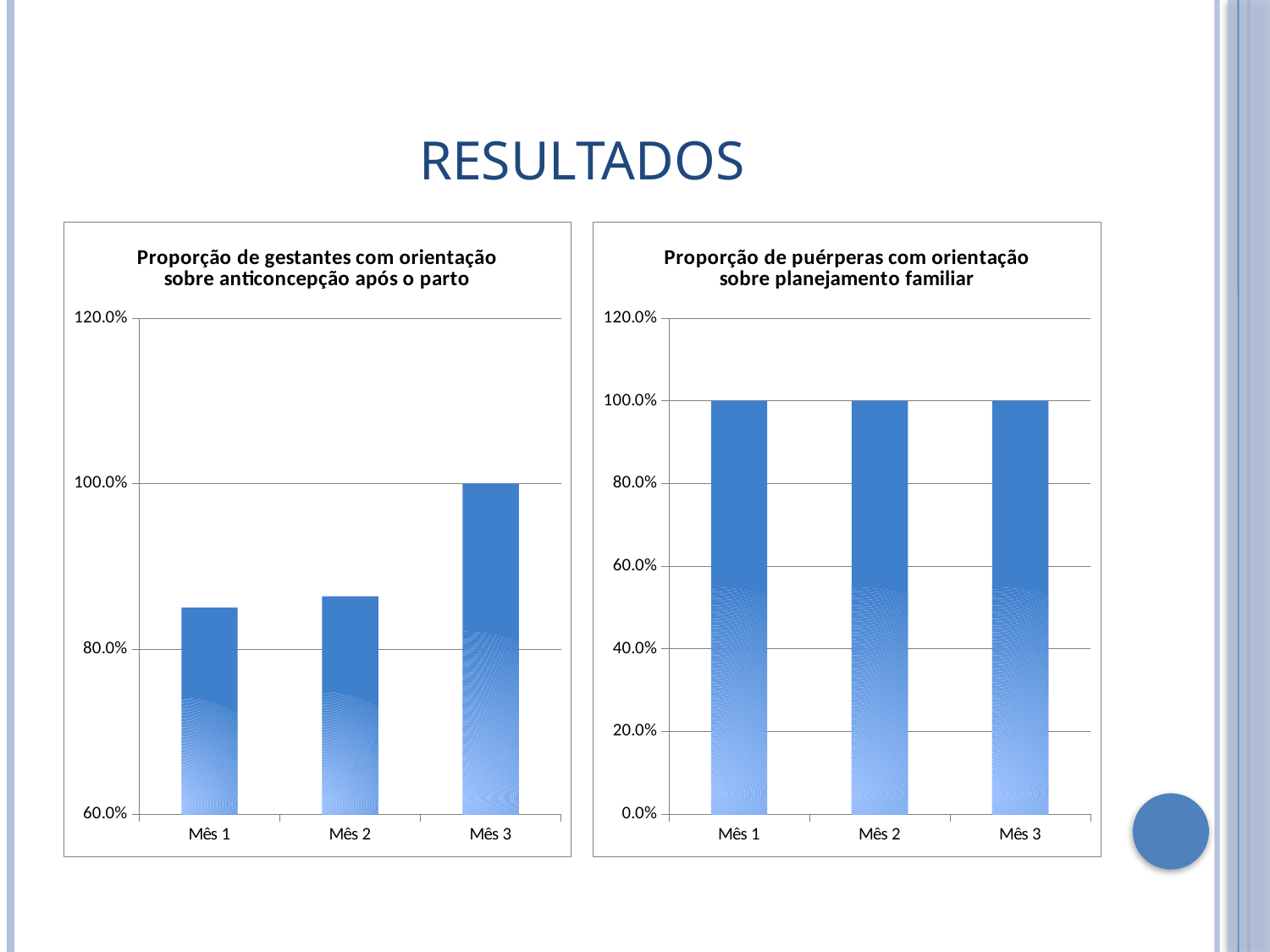
In the right chart (puérperas com orientação sobre planejamento familiar), how many bars are plotted? 3 In the chart titled 'Proporção de puérperas com orientação sobre planejamento familiar', what is the value for Mês 3? 100.0% In the left chart (gestantes com orientação sobre anticoncepção), how many months are shown on the x axis? 3 In the left chart (gestantes com orientação sobre anticoncepção), is the value for Mês 2 greater or less than 100.0%? less What is the lowest value shown on the y axis of the left chart (gestantes com orientação sobre anticoncepção)? 60.0% In the left chart (gestantes com orientação sobre anticoncepção), do the values rise or fall from Mês 1 to Mês 3? rise What kind of chart is the right chart titled 'Proporção de puérperas com orientação sobre planejamento familiar'? bar chart In the left chart (gestantes com orientação sobre anticoncepção), is the value for Mês 1 greater or less than 80.0%? greater In the chart titled 'Proporção de gestantes com orientação sobre anticoncepção após o parto', what is the value for Mês 3? 100.0% In the chart titled 'Proporção de puérperas com orientação sobre planejamento familiar', what is the value for Mês 1? 100.0% In the chart titled 'Proporção de gestantes com orientação sobre anticoncepção após o parto', which month has the highest value? Mês 3 What kind of chart is the left chart titled 'Proporção de gestantes com orientação sobre anticoncepção após o parto'? bar chart